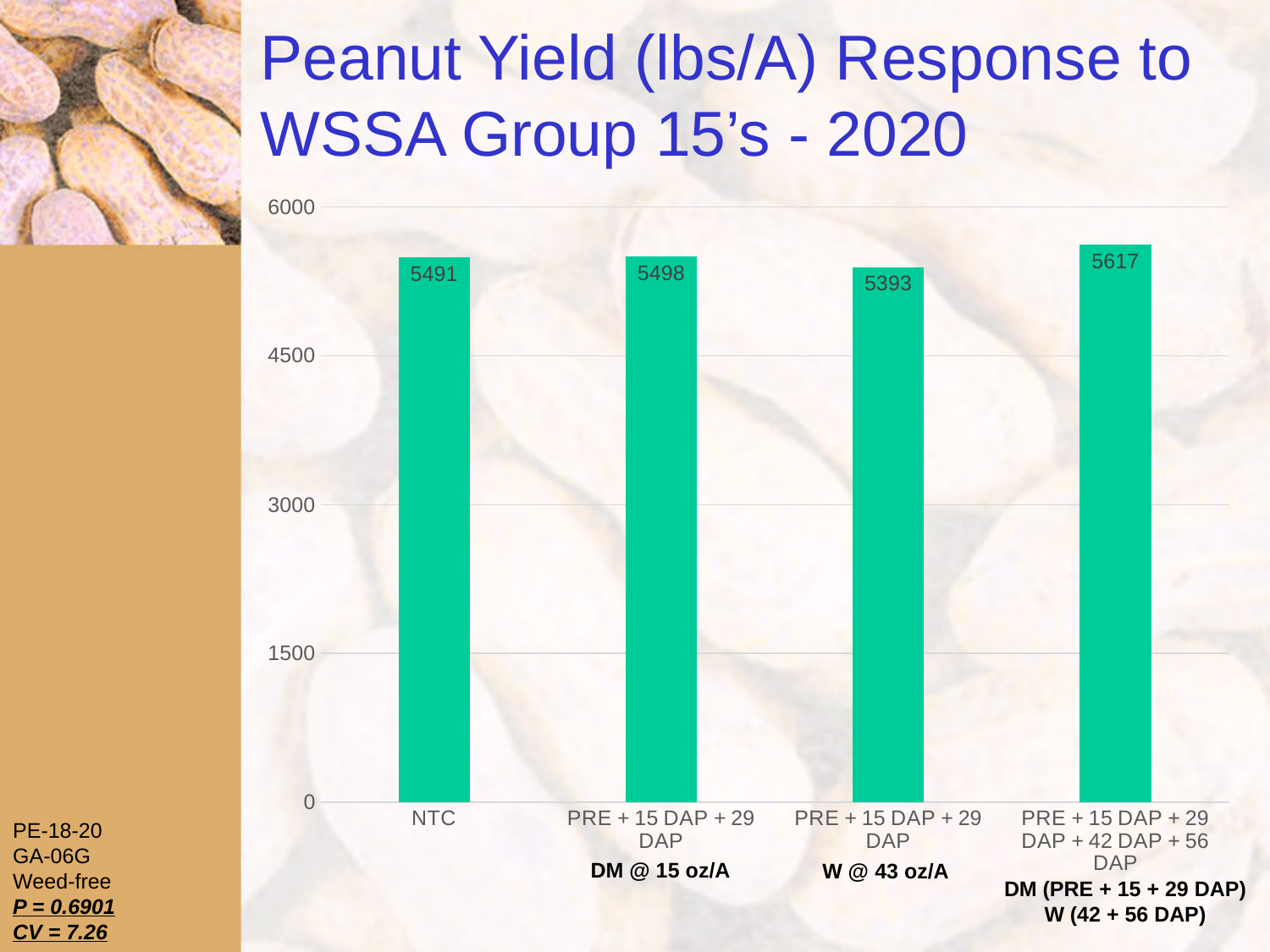
Is the yield for NTC greater or less than 4500? greater What is the difference in yield between the PRE + 15 DAP + 29 DAP + 42 DAP + 56 DAP treatment and the W @ 43 oz/A treatment? 224 What is the peanut yield for the NTC treatment? 5491 What is the difference in yield between the PRE + 15 DAP + 29 DAP + 42 DAP + 56 DAP treatment and NTC? 126 Which treatment has the highest peanut yield? PRE + 15 DAP + 29 DAP + 42 DAP + 56 DAP What is the peanut yield for the PRE + 15 DAP + 29 DAP treatment with W @ 43 oz/A? 5393 How many treatments are shown in the chart? 4 Which treatment has the lowest peanut yield? PRE + 15 DAP + 29 DAP (W @ 43 oz/A) What is the peanut yield for the PRE + 15 DAP + 29 DAP + 42 DAP + 56 DAP treatment? 5617 What type of chart is shown on the slide? bar chart What is the peanut yield for the PRE + 15 DAP + 29 DAP treatment with DM @ 15 oz/A? 5498 Which has a higher yield, the PRE + 15 DAP + 29 DAP + 42 DAP + 56 DAP treatment or the W @ 43 oz/A treatment? PRE + 15 DAP + 29 DAP + 42 DAP + 56 DAP